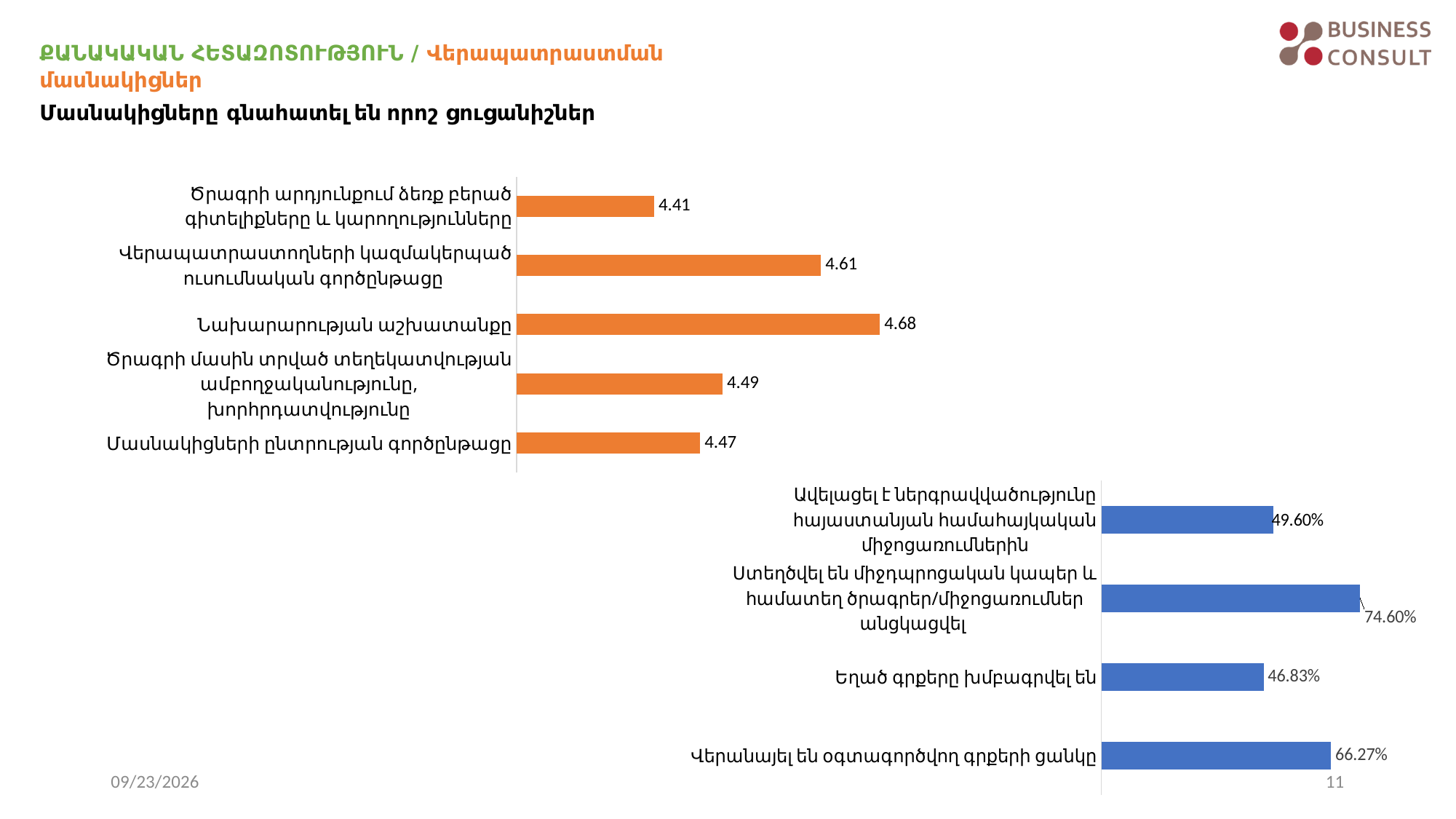
In the blue bar chart at the bottom right, which category has the highest value? Ստեղծվել են միջդպրոցական կապեր և համատեղ ծրագրեր/միջոցառումներ անցկացվել In the orange bar chart at the top left, what is the value for "Մասնակիցների ընտրության գործընթացը"? 4.47 How many categories are shown in the blue bar chart at the bottom right? 4 What type of chart is the blue chart at the bottom right of the slide? Bar chart In the blue bar chart at the bottom right, what is the value for "Եղած գրքերը խմբագրվել են"? 46.83% How many categories are shown in the orange bar chart at the top left? 5 In the blue bar chart at the bottom right, what is the value for "Վերանայել են օգտագործվող գրքերի ցանկը"? 66.27% In the orange bar chart at the top left, what is the value for "Նախարարության աշխատանքը"? 4.68 In the blue bar chart at the bottom right, which is larger: the value for "Ավելացել է ներգրավվածությունը հայաստանյան համահայկական միջոցառումներին" or for "Եղած գրքերը խմբագրվել են"? Ավելացել է ներգրավվածությունը հայաստանյան համահայկական միջոցառումներին In the orange bar chart at the top left, which category has the highest value? Նախարարության աշխատանքը In the orange bar chart at the top left, what is the difference between the values for "Վերապատրաստողների կազմակերպած ուսումնական գործընթացը" and "Ծրագրի արդյունքում ձեռք բերած գիտելիքները և կարողությունները"? 0.20 In the orange bar chart at the top left, which category has the lowest value? Ծրագրի արդյունքում ձեռք բերած գիտելիքները և կարողությունները